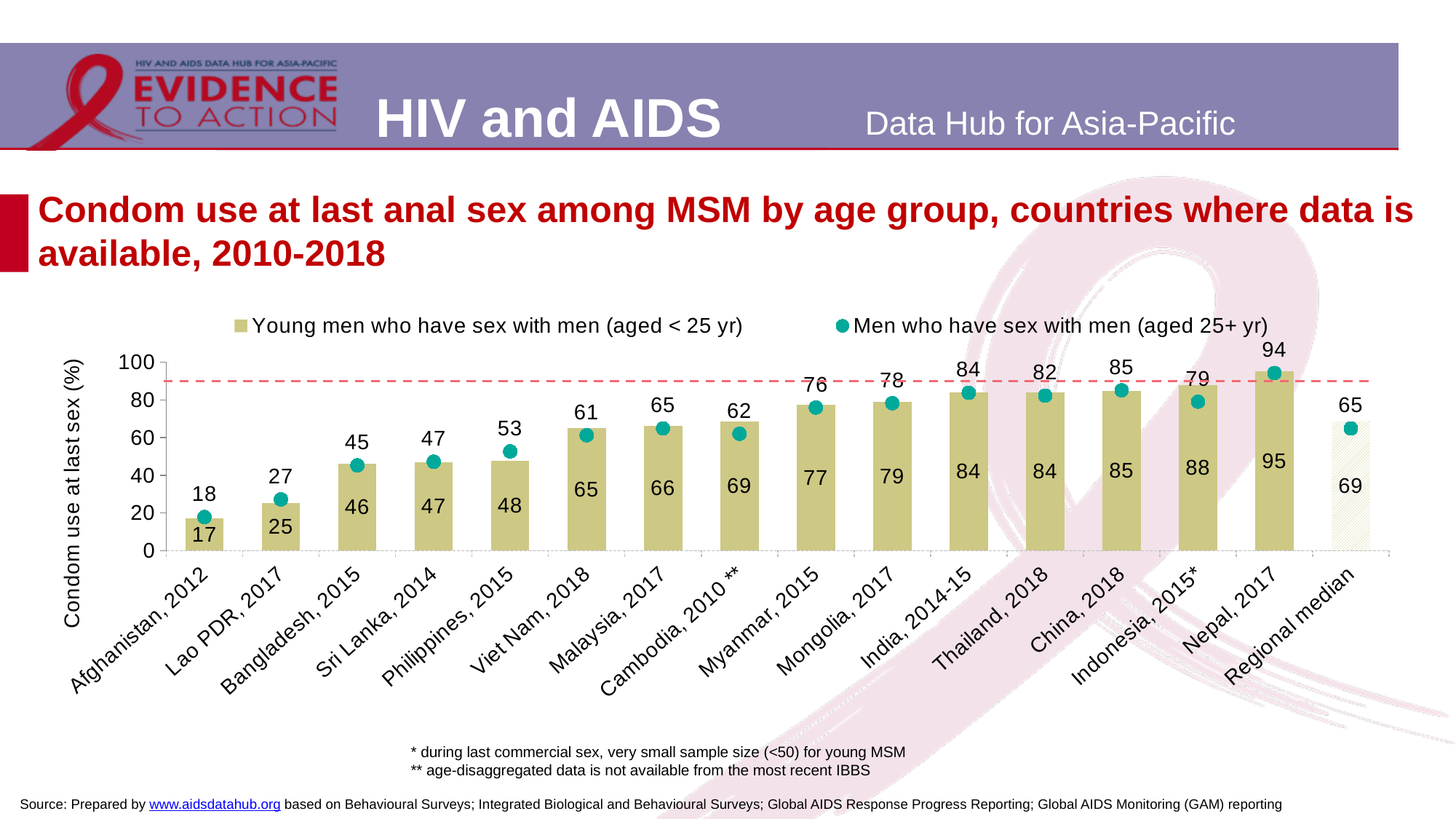
What is the difference between the young MSM (aged < 25 yr) value and the MSM (aged 25+ yr) value for Indonesia, 2015*? 9 What is the value for men who have sex with men (aged 25+ yr) in Thailand, 2018? 82 What kind of chart is shown on the slide? Combination chart: bars with dot markers (bar and line chart) What is the value for young men who have sex with men (aged < 25 yr) for the Regional median? 69 How many categories are shown on the x axis of the chart? 16 What is the value for men who have sex with men (aged 25+ yr) in Afghanistan, 2012? 18 Which country has the lowest value for young men who have sex with men (aged < 25 yr)? Afghanistan, 2012 Which country has the highest value for young men who have sex with men (aged < 25 yr)? Nepal, 2017 For Cambodia, 2010 **, which is larger: the value for young MSM (aged < 25 yr) or for MSM (aged 25+ yr)? Young men who have sex with men (aged < 25 yr) How many series does the legend list? 2 What is the difference between the young MSM (aged < 25 yr) values for Nepal, 2017 and Afghanistan, 2012? 78 What is the value for young men who have sex with men (aged < 25 yr) in Nepal, 2017? 95